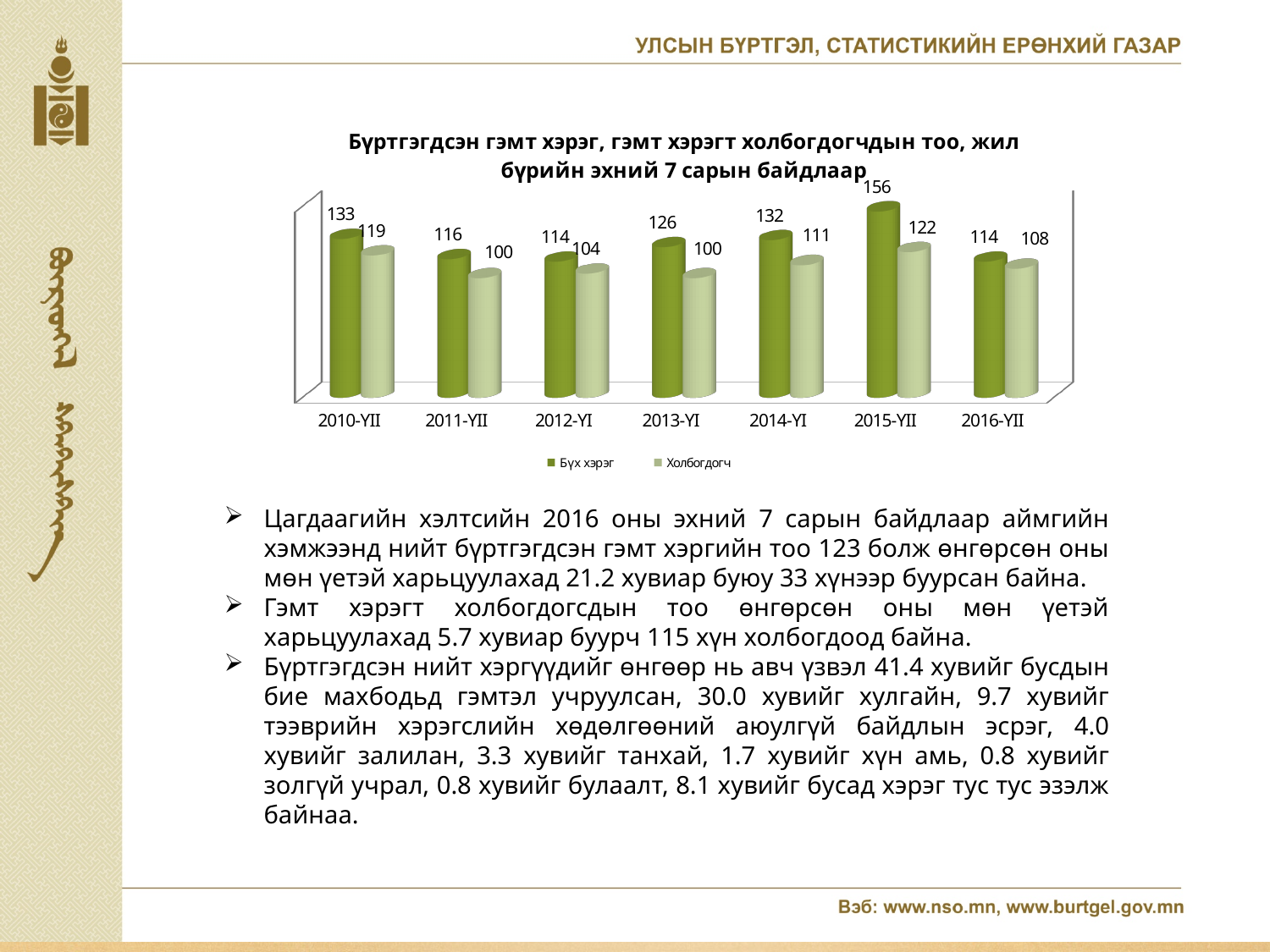
What is the difference between the Бүх хэрэг values for 2015-YII and 2016-YII? 42 How many series does the legend list? 2 What is the difference between Бүх хэрэг and Холбогдогч for 2016-YII? 6 Which category has the highest value for Бүх хэрэг? 2015-YII How many categories are shown on the x axis? 7 Which category has the highest value for Холбогдогч? 2015-YII What is the value of Бүх хэрэг for 2015-YII? 156 Which is larger, the Холбогдогч value for 2014-YI or for 2012-YI? 2014-YI What kind of chart is shown on the slide? Bar chart What is the value of Холбогдогч for 2010-YII? 119 What is the value of Холбогдогч for 2016-YII? 108 What is the value of Бүх хэрэг for 2013-YI? 126